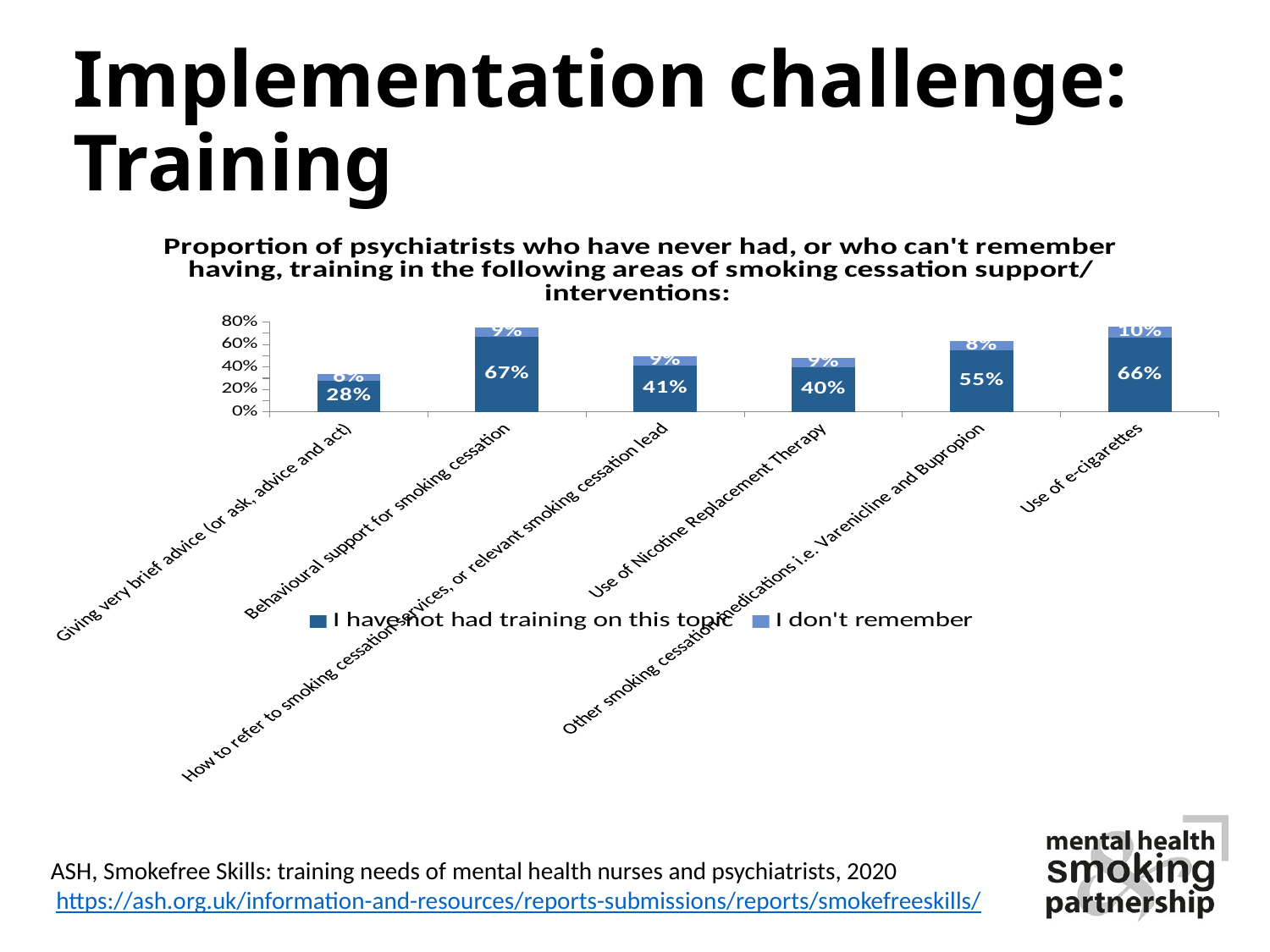
What proportion of psychiatrists have not had training on behavioural support for smoking cessation? 67% What proportion of psychiatrists have not had training on use of e-cigarettes? 66% What proportion of psychiatrists have not had training on giving very brief advice? 28% How many series does the legend list? 2 Which has a larger 'I have not had training on this topic' value: how to refer to smoking cessation services or use of Nicotine Replacement Therapy? How to refer to smoking cessation services What is the total stacked value for other smoking cessation medications (55% not had training plus 8% don't remember)? 63% What kind of chart is shown on the slide? Stacked bar chart Which training area has the lowest proportion of psychiatrists who have not had training on the topic? Giving very brief advice (or ask, advice and act) How many training areas (categories) are shown on the x axis? 6 What proportion of psychiatrists have not had training on other smoking cessation medications (Varenicline and Bupropion)? 55% Which training area has the highest proportion of psychiatrists who have not had training on the topic? Behavioural support for smoking cessation What is the difference between the 'I have not had training' values for behavioural support (67%) and use of Nicotine Replacement Therapy (40%)? 27%